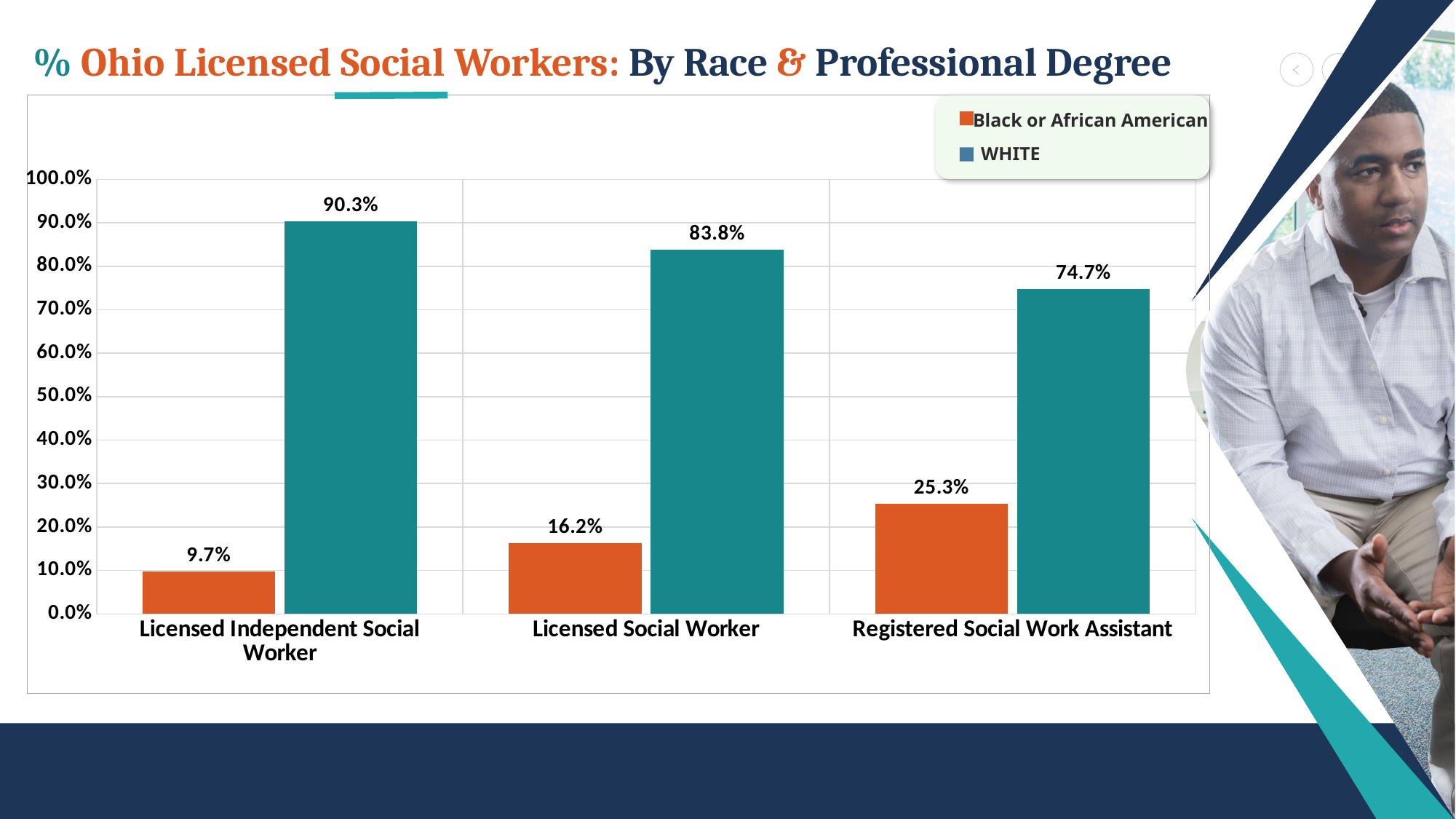
How many series does the legend list? 2 What kind of chart is shown on the slide? Bar chart Which professional degree category has the highest WHITE percentage? Licensed Independent Social Worker Do the WHITE percentages rise or fall moving from left to right across the categories? Fall What percentage of Licensed Independent Social Workers are Black or African American? 9.7% What percentage of Licensed Social Workers are WHITE? 83.8% How many professional degree categories are shown on the x axis? 3 What percentage of Registered Social Work Assistants are Black or African American? 25.3% What is the difference between the WHITE and Black or African American percentages for Registered Social Work Assistant? 49.4% Which professional degree category has the lowest Black or African American percentage? Licensed Independent Social Worker Is the WHITE value for Registered Social Work Assistant greater or less than 80.0%? less Is the Black or African American percentage higher for Licensed Social Worker or for Registered Social Work Assistant? Registered Social Work Assistant